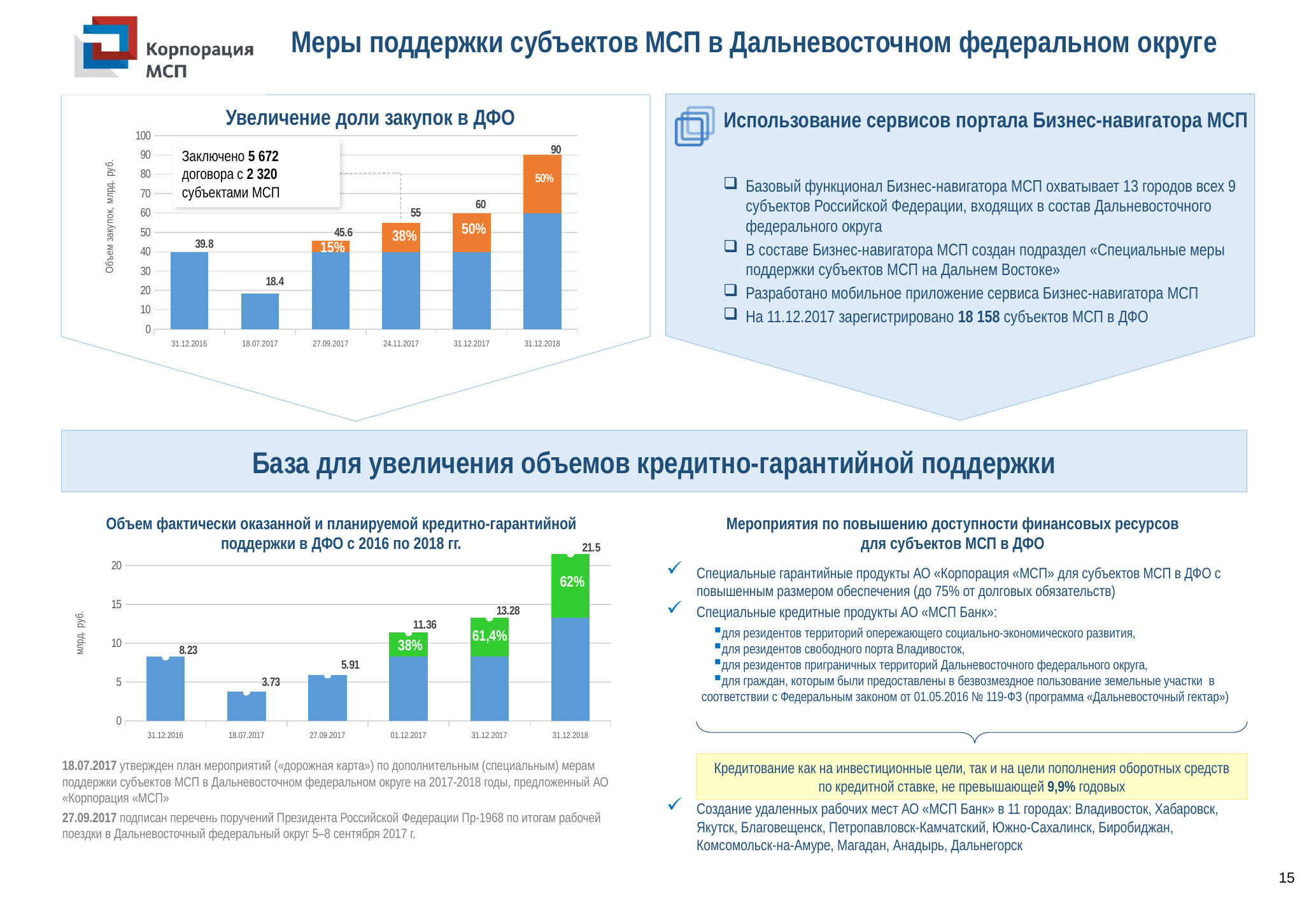
In the chart 'Увеличение доли закупок в ДФО', what is the difference between the values for 31.12.2017 and 24.11.2017? 5 In the chart 'Увеличение доли закупок в ДФО', what percentage label is shown on the orange segment for 24.11.2017? 38% What type of chart is the bottom-left chart on credit-guarantee support? Bar chart In the bottom-left chart on credit-guarantee support, which is larger: the value for 31.12.2016 or the value for 27.09.2017? 31.12.2016 In the chart 'Увеличение доли закупок в ДФО', what is the value for 31.12.2018? 90 In the bottom-left chart on credit-guarantee support, what is the value for 31.12.2018? 21.5 In the bottom-left chart on credit-guarantee support, what is the value for 01.12.2017? 11.36 In the chart 'Увеличение доли закупок в ДФО', what is the y-axis label? Объем закупок, млрд. руб. In the bottom-left chart on credit-guarantee support, which date has the highest value? 31.12.2018 In the chart 'Увеличение доли закупок в ДФО', what is the value for 27.09.2017? 45.6 In the chart 'Увеличение доли закупок в ДФО', how many dates are shown on the x axis? 6 In the chart 'Увеличение доли закупок в ДФО', which date has the lowest value? 18.07.2017